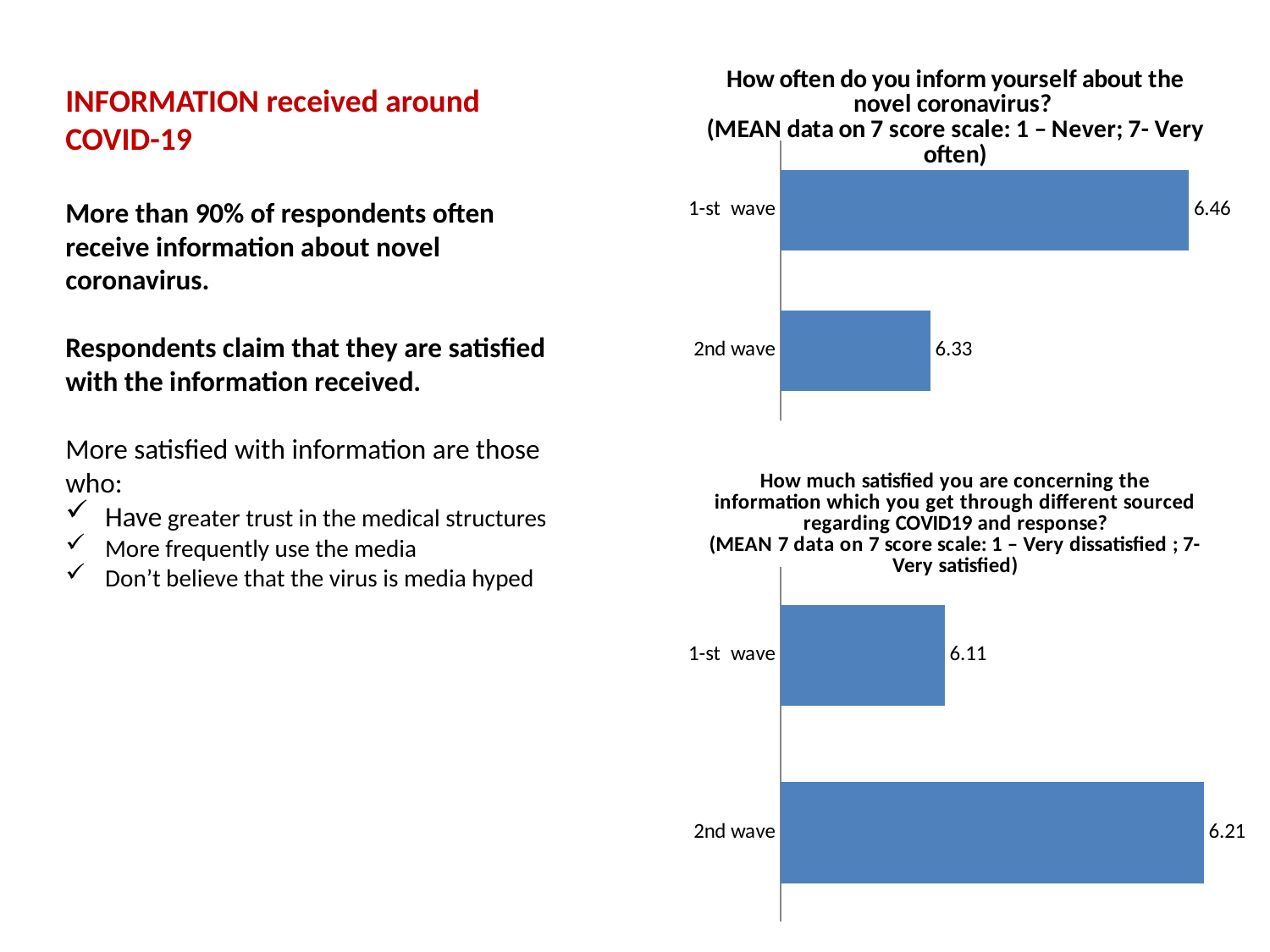
In the bottom chart (How much satisfied you are concerning the information...), what is the difference between the 2nd wave and 1-st wave values? 0.10 In the top chart (How often do you inform yourself about the novel coronavirus?), what is the difference between the 1-st wave and 2nd wave values? 0.13 In the top chart (How often do you inform yourself about the novel coronavirus?), which wave has the higher value? 1-st wave In the top chart (How often do you inform yourself about the novel coronavirus?), what is the value for 2nd wave? 6.33 In the bottom chart (How much satisfied you are concerning the information...), what is the value for 2nd wave? 6.21 How many categories are shown in the top chart (How often do you inform yourself about the novel coronavirus?)? 2 What type of chart is the bottom chart (How much satisfied you are concerning the information...)? bar chart In the bottom chart (How much satisfied you are concerning the information...), which wave has the lower value? 1-st wave In the bottom chart (How much satisfied you are concerning the information...), what is the value for 1-st wave? 6.11 How many charts are shown on the slide? 2 In the bottom chart (How much satisfied you are concerning the information...), is the value for 2nd wave larger or smaller than the value for 1-st wave? larger In the top chart (How often do you inform yourself about the novel coronavirus?), what is the value for 1-st wave? 6.46